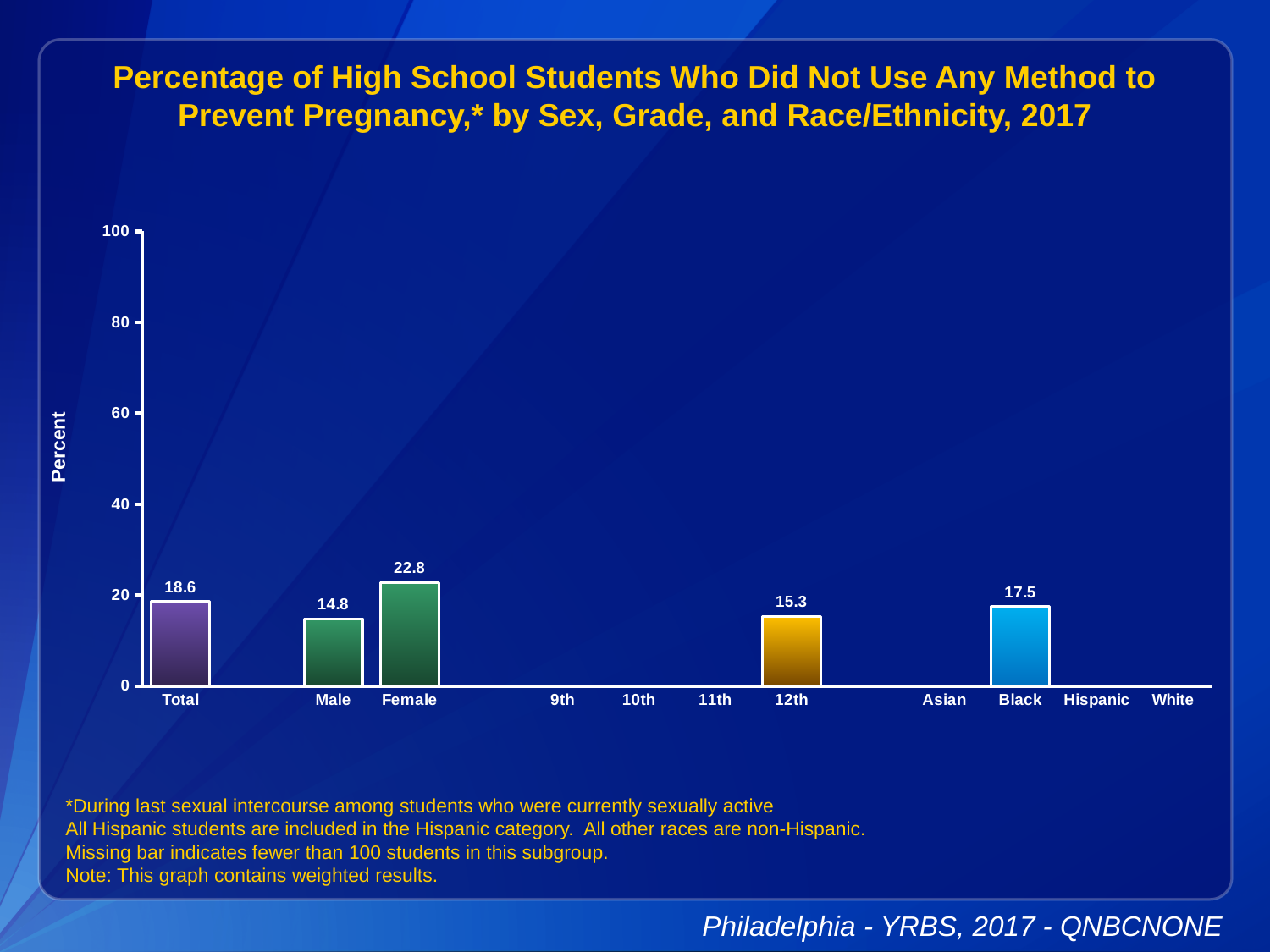
Which category has the lowest value among the bars shown? Male How many bars are plotted on the chart? 5 What is the value for 12th grade? 15.3 What is the value for Black students? 17.5 Which category has the highest value? Female What is the difference between the Female and Male values? 8.0 Which is larger, the value for Black or the value for 12th? Black What is the value for Total? 18.6 What is the value for Female? 22.8 What kind of chart is this? bar chart What is the value for Male? 14.8 Is the value for Female greater or less than 20? greater